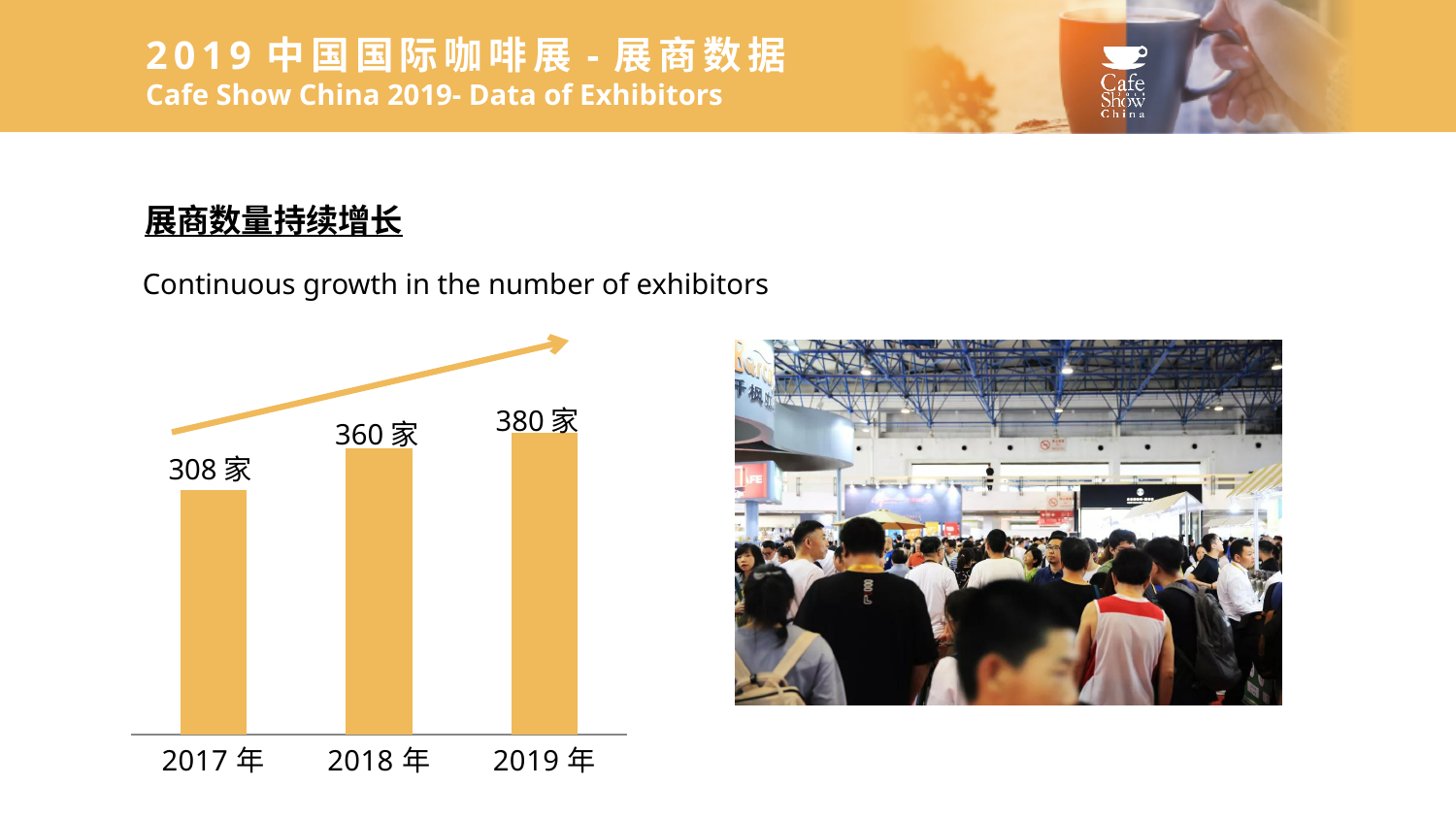
What is the difference in the number of exhibitors between 2019 年 and 2017 年? 72 家 What colour are the bars in the chart? Orange/yellow How many years are shown in the chart? 3 Which has more exhibitors, 2018 年 or 2019 年? 2019 年 Which year has the lowest number of exhibitors? 2017 年 What kind of chart is shown on the slide? Bar chart What is the number of exhibitors shown for 2018 年? 360 家 What is the number of exhibitors shown for 2017 年? 308 家 Do the values rise or fall from 2017 年 to 2019 年? Rise What is the difference in the number of exhibitors between 2018 年 and 2017 年? 52 家 What is the number of exhibitors shown for 2019 年? 380 家 Which year has the highest number of exhibitors? 2019 年